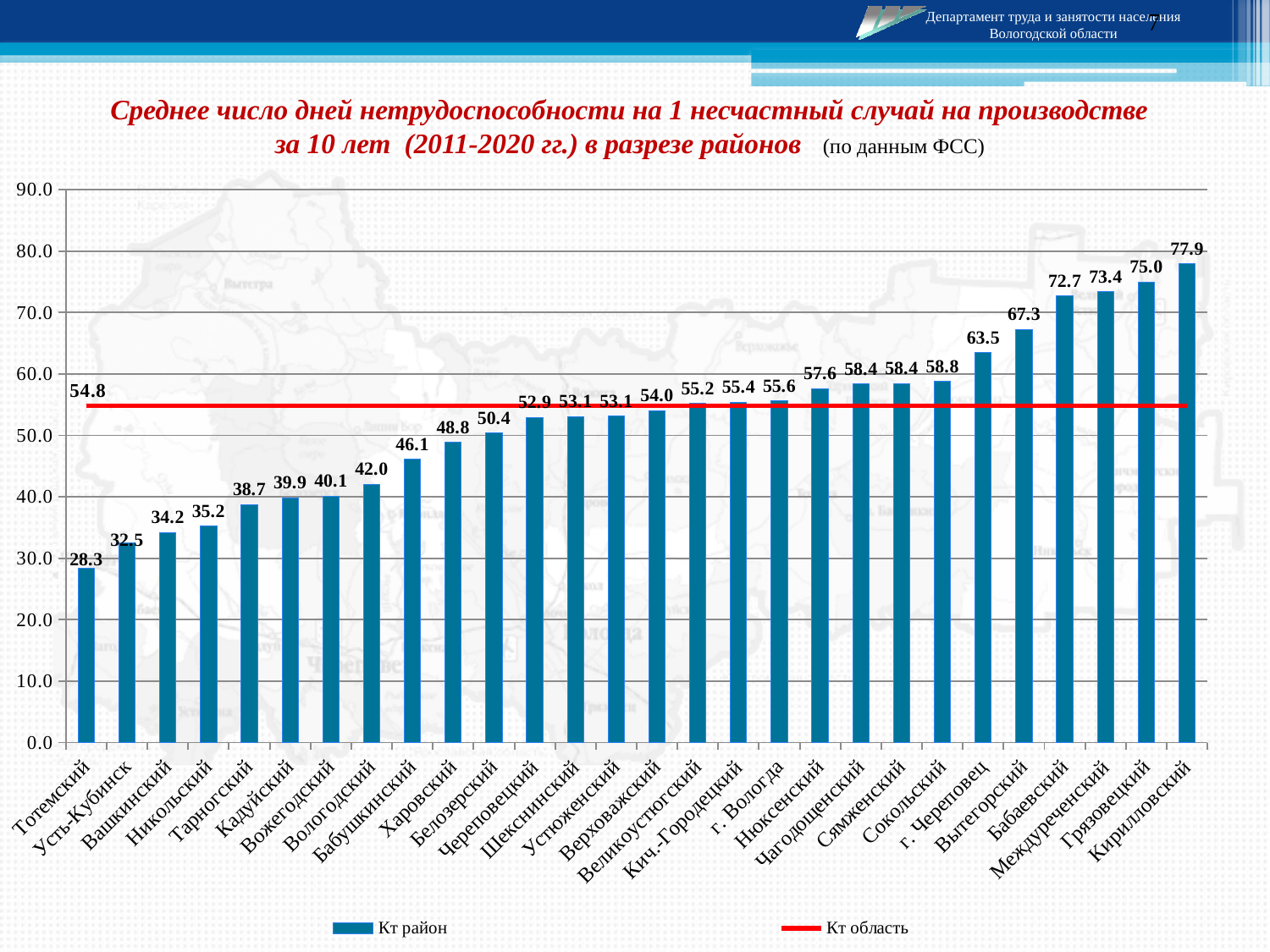
Do the bar values rise or fall from left to right along the x axis? Rise Which is larger, the value for Вытегорский or the value for г. Череповец? Вытегорский What is the value for г. Вологда? 55.6 What kind of chart is shown on the slide? Bar chart What is the difference between the values for Кирилловский and Тотемский? 49.6 What is the value for Бабушкинский? 46.1 How many entries does the legend list? 2 What is the value for Кирилловский? 77.9 How many districts (bars) are shown in the chart? 28 What is the value of the red line labelled Кт область? 54.8 Which district has the lowest value? Тотемский Which district has the highest value? Кирилловский